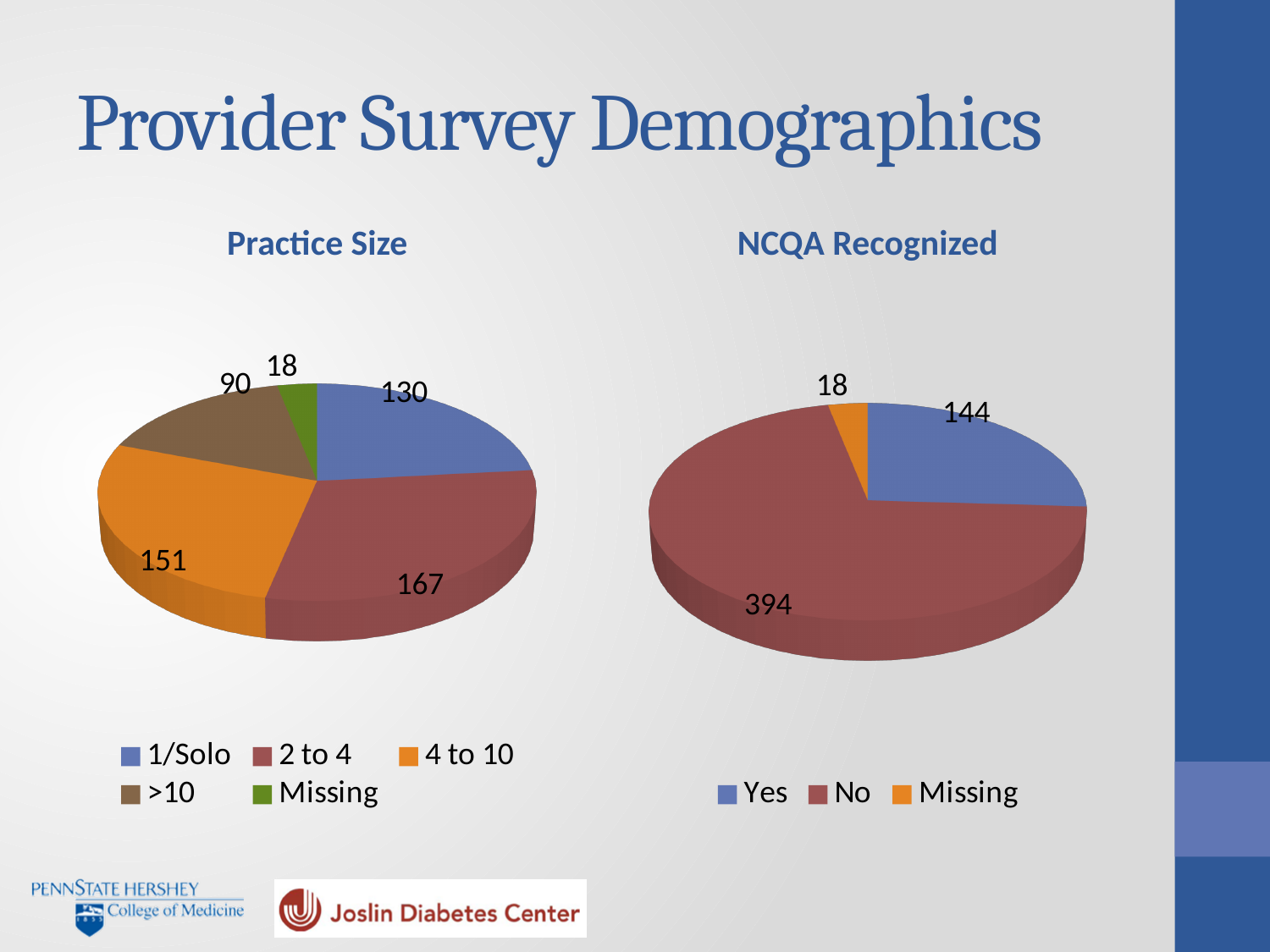
In the Practice Size chart, which category has the largest value? 2 to 4 In the Practice Size chart, which is larger: 1/Solo or >10? 1/Solo In the Practice Size chart, what is the value for the 2 to 4 category? 167 How many categories does the Practice Size chart show? 5 In the NCQA Recognized chart, what is the value for No? 394 In the NCQA Recognized chart, what is the value for Yes? 144 In the Practice Size chart, what is the difference between the 2 to 4 and 4 to 10 values? 16 How many categories does the NCQA Recognized chart show? 3 In the Practice Size chart, which category has the smallest value? Missing In the NCQA Recognized chart, what is the difference between the No and Yes values? 250 What kind of chart is the NCQA Recognized chart? Pie chart In the Practice Size chart, what is the value for the >10 category? 90